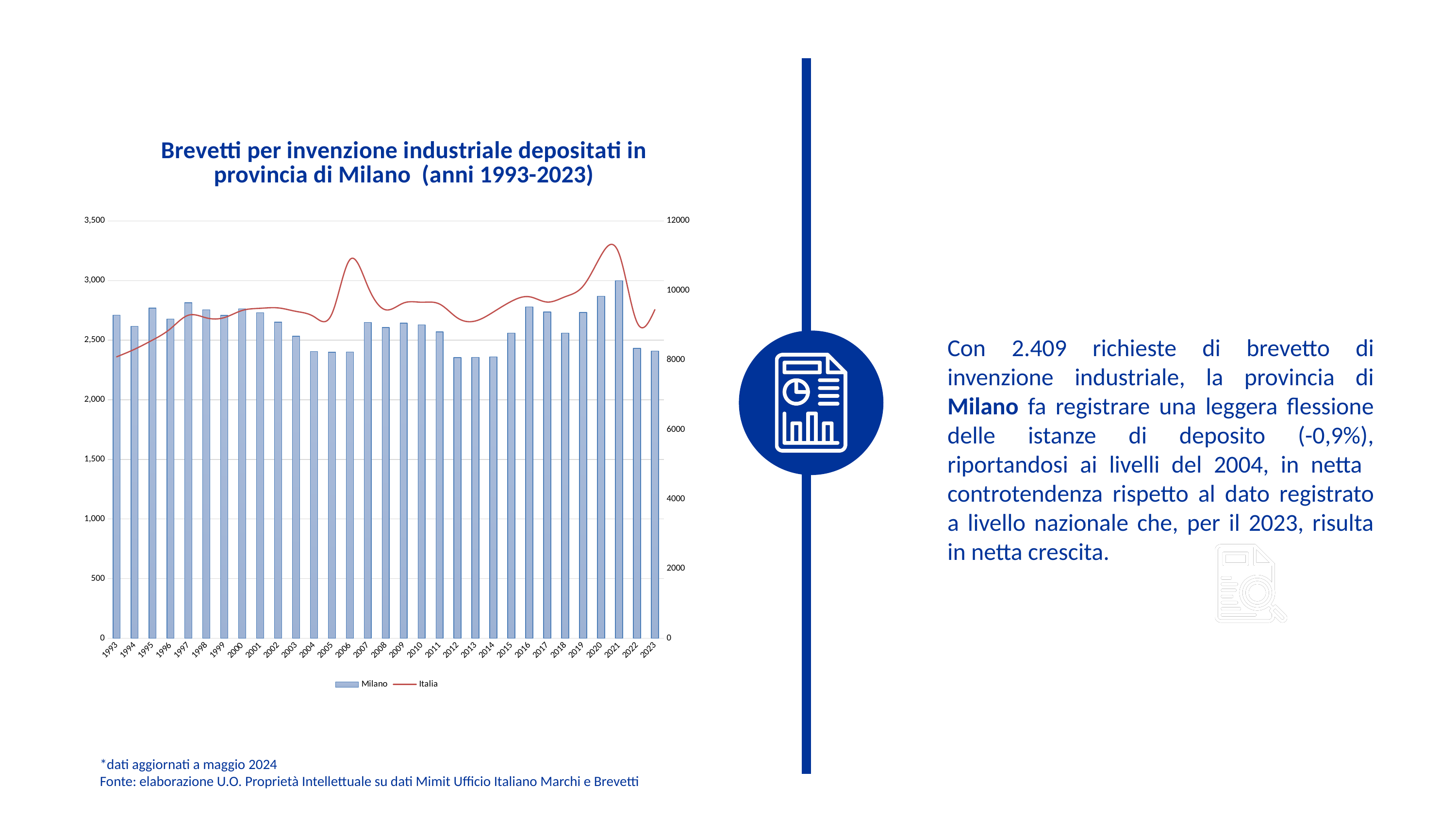
Is the Italia value for 2006 greater or less than 10000? greater Is the Milano value for 2023 greater or less than 2,500? less What kind of chart is shown on the slide? A combined bar and line chart Is the Milano value for 2021 greater or less than 2,500? greater In which year is the Milano bar highest? 2021 Which series are listed in the chart legend? Milano and Italia Which is larger, the Milano value for 2021 or for 2023? 2021 Do the Milano bars rise or fall from 2021 to 2023? fall How many series does the chart legend list? 2 How many years are plotted along the x axis of the chart? 31 In which year does the Italia line reach its highest point? 2021